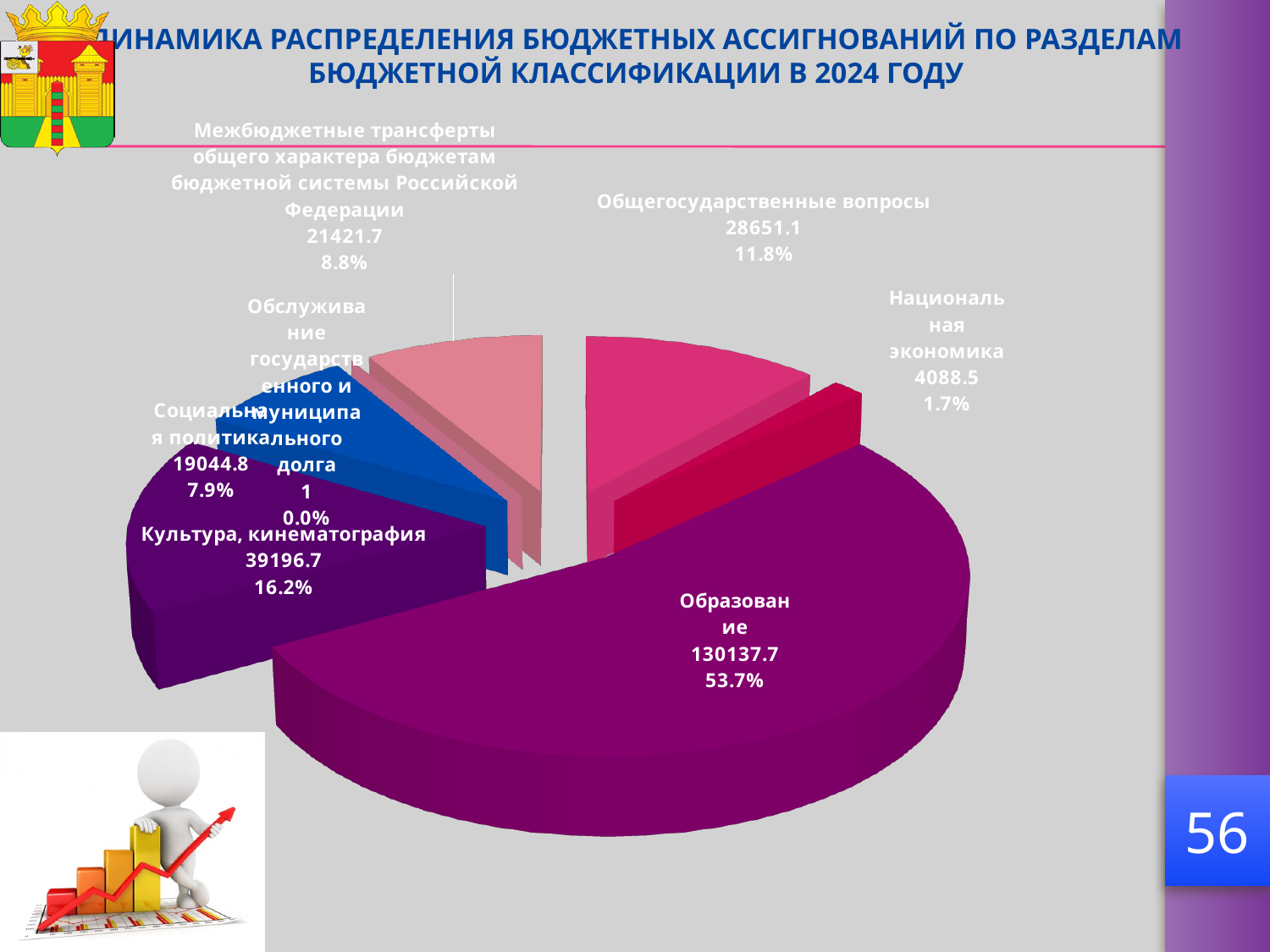
What is the difference between the values for Культура, кинематография and Социальная политика? 20151.9 What percentage is shown for Межбюджетные трансферты общего характера бюджетам бюджетной системы Российской Федерации? 8.8% Which category has the smallest slice of the pie? Обслуживание государственного и муниципального долга How many categories are shown in the pie chart? 7 Which category has the largest slice of the pie? Образование What value is shown for Национальная экономика? 4088.5 What kind of chart is shown on the slide? Pie chart Which is larger: the value for Социальная политика or the value for Общегосударственные вопросы? Общегосударственные вопросы What value is shown for Культура, кинематография? 39196.7 What share of the pie does Образование represent? 53.7% What percentage is shown for Общегосударственные вопросы? 11.8% What value is shown for Образование? 130137.7